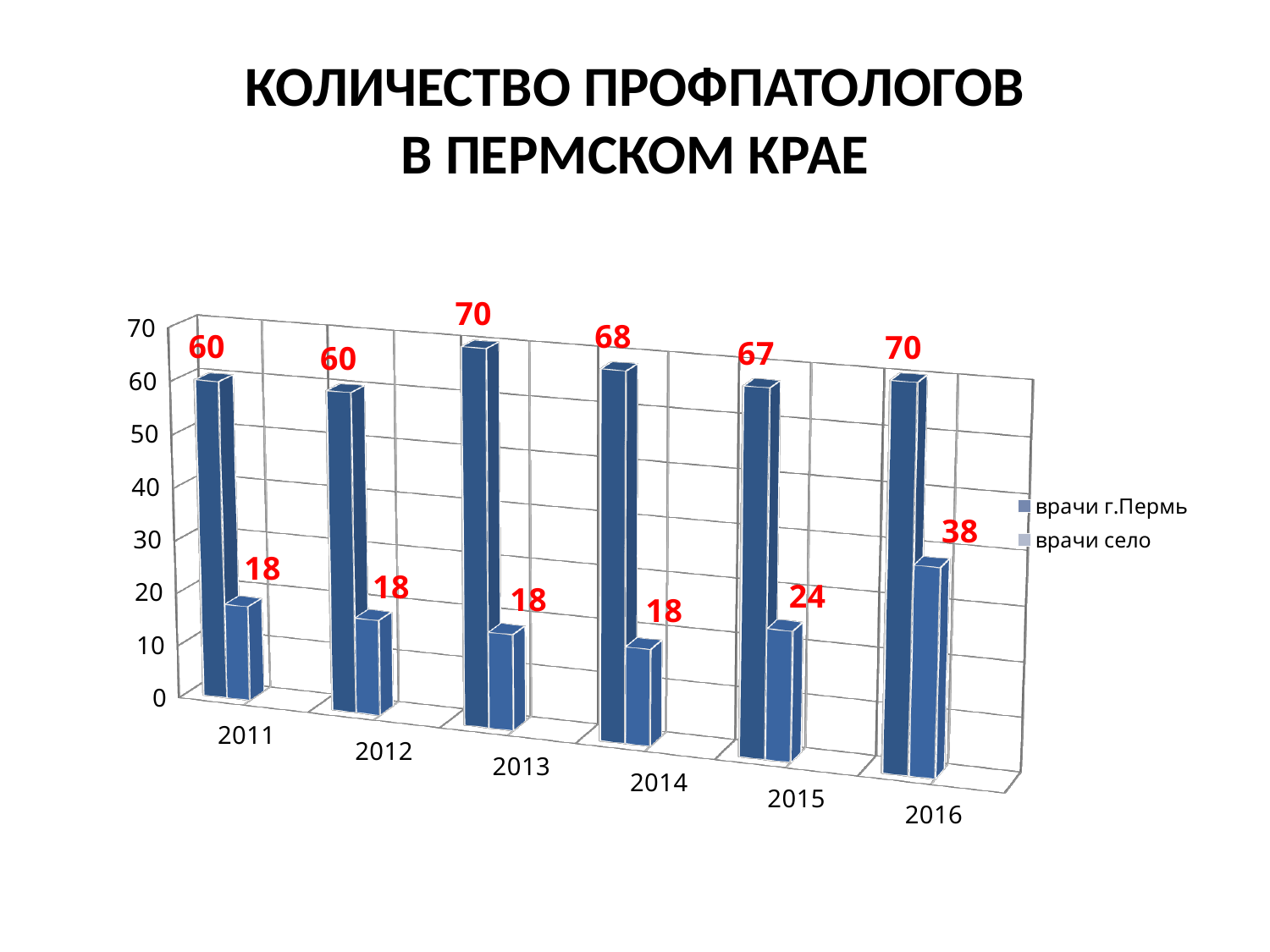
Does the value for врачи село rise or fall from 2015 to 2016? rise What kind of chart is shown on the slide? bar chart What is the value for врачи г.Пермь in 2013? 70 How many years are shown on the x axis? 6 What is the value for врачи г.Пермь in 2015? 67 Which is larger in 2015: врачи г.Пермь or врачи село? врачи г.Пермь How many series does the legend list? 2 In which year is the value for врачи г.Пермь lowest? 2011 and 2012 In which year is the value for врачи село highest? 2016 What is the difference between врачи г.Пермь and врачи село in 2014? 50 What is the title of the slide? КОЛИЧЕСТВО ПРОФПАТОЛОГОВ В ПЕРМСКОМ КРАЕ What is the value for врачи село in 2016? 38